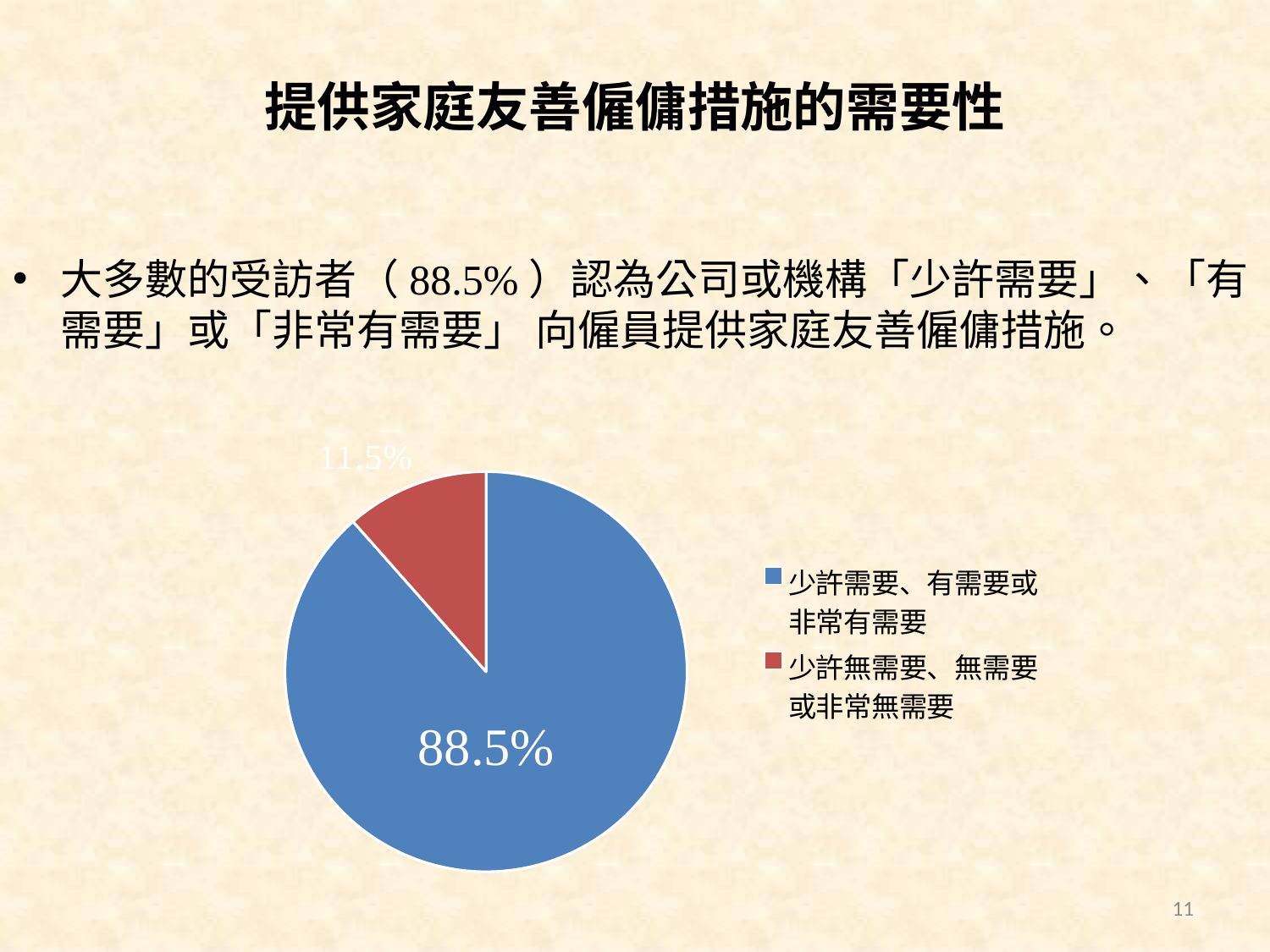
What kind of chart is shown on the slide? pie chart What share of the pie is labelled 少許無需要、無需要或非常無需要? 11.5% Which category has the smallest slice of the pie? 少許無需要、無需要或非常無需要 Which category has the largest slice of the pie? 少許需要、有需要或非常有需要 What colour is the slice for 少許無需要、無需要或非常無需要? red How many entries does the legend list? 2 How many slices does the pie chart have? 2 What is the difference between the two slices of the pie? 77.0% What share of the pie is labelled 少許需要、有需要或非常有需要? 88.5% What colour is the slice for 少許需要、有需要或非常有需要? blue Which is larger: the slice for 少許需要、有需要或非常有需要 or the slice for 少許無需要、無需要或非常無需要? 少許需要、有需要或非常有需要